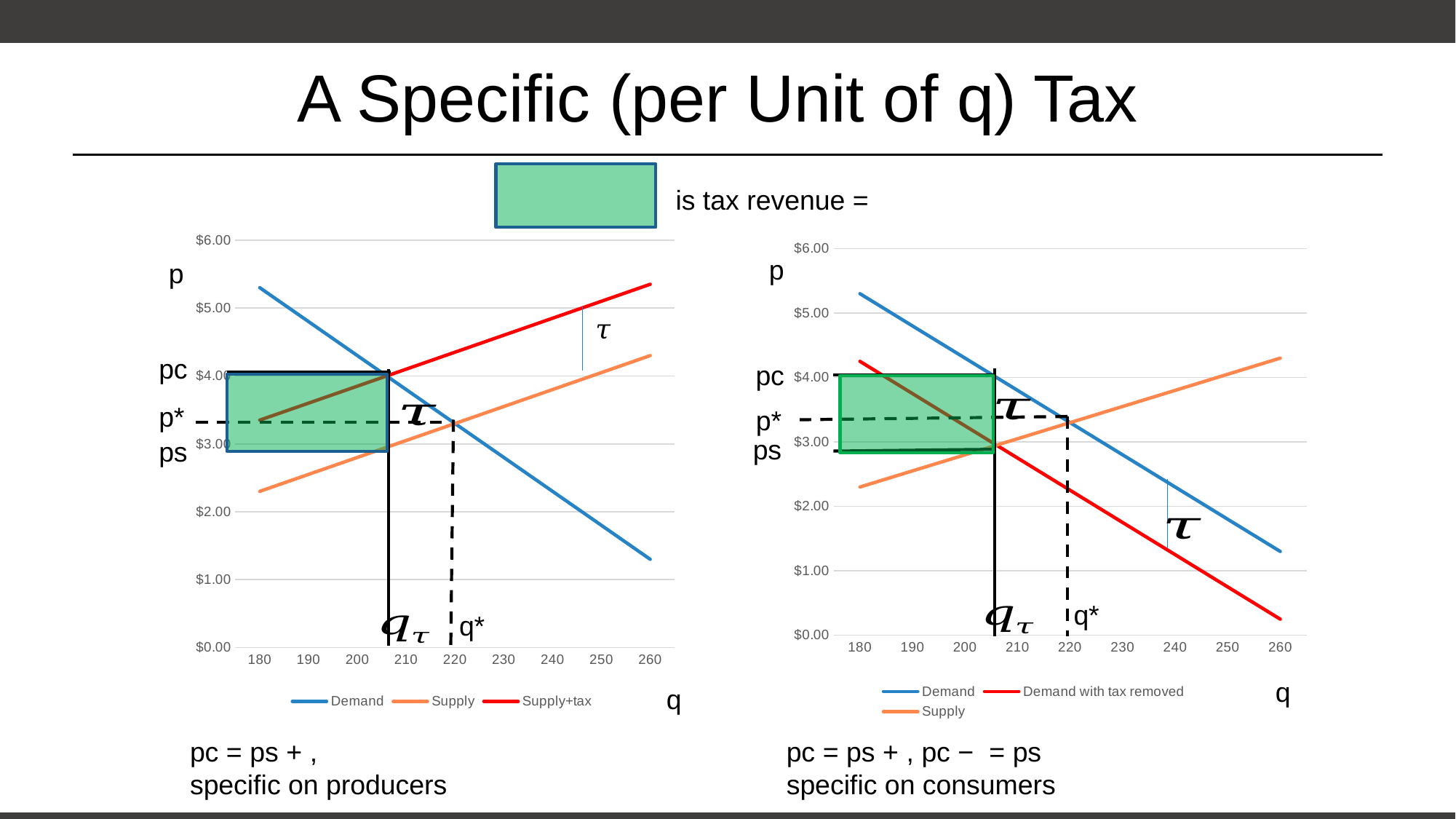
In the right chart, is the value of Demand with tax removed at q = 260 greater or less than $1.00? less What kind of chart is the left chart on the slide? line chart In the left chart, at q = 260, which is higher: Supply+tax or Supply? Supply+tax In the left chart, is the value of Demand at q = 180 greater or less than $5.00? greater In the left chart, does the Demand line rise or fall as q increases? fall In the right chart, at q = 180, which is higher: Demand or Demand with tax removed? Demand In the left chart, is the value of Demand at q = 260 greater or less than $2.00? less In the left chart, which series are listed in the legend? Demand, Supply, Supply+tax How many series does the legend of the right chart list? 3 In the right chart, does the Supply line rise or fall as q increases? rise In the right chart, which series are listed in the legend? Demand, Demand with tax removed, Supply How many series does the legend of the left chart list? 3